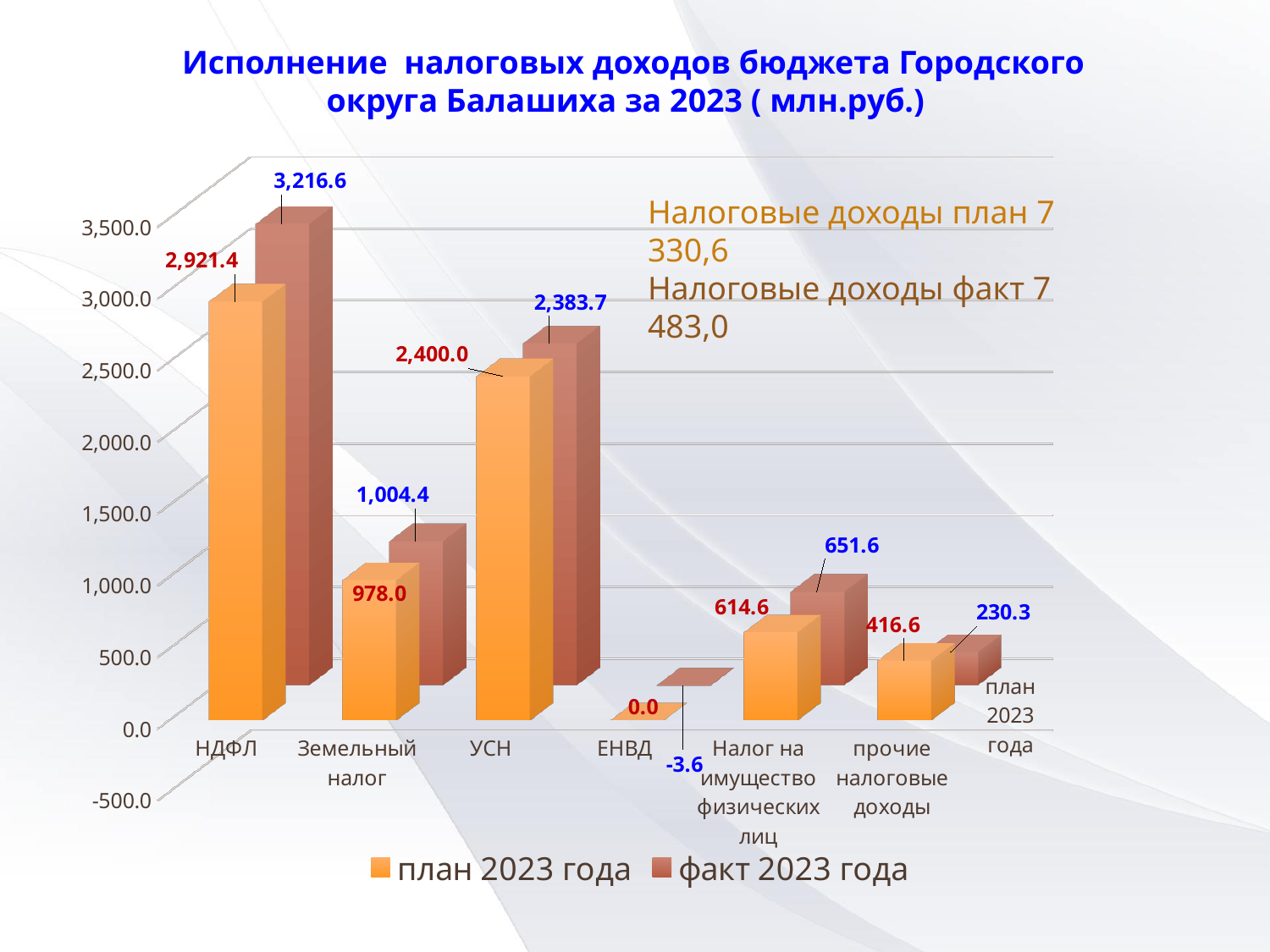
How many series does the legend list? 2 For УСН, which is larger: план 2023 года or факт 2023 года? план 2023 года Which category has the highest факт 2023 года value? НДФЛ What kind of chart is shown on the slide? bar chart What is the факт 2023 года value for ЕНВД? -3.6 What is the difference between the план 2023 года and факт 2023 года values for прочие налоговые доходы? 186.3 What is the difference between the факт 2023 года and план 2023 года values for НДФЛ? 295.2 Which category has the lowest план 2023 года value? ЕНВД What is the план 2023 года value for прочие налоговые доходы? 416.6 How many categories are shown on the x axis? 6 What is the факт 2023 года value for Земельный налог? 1,004.4 What is the план 2023 года value for НДФЛ? 2,921.4